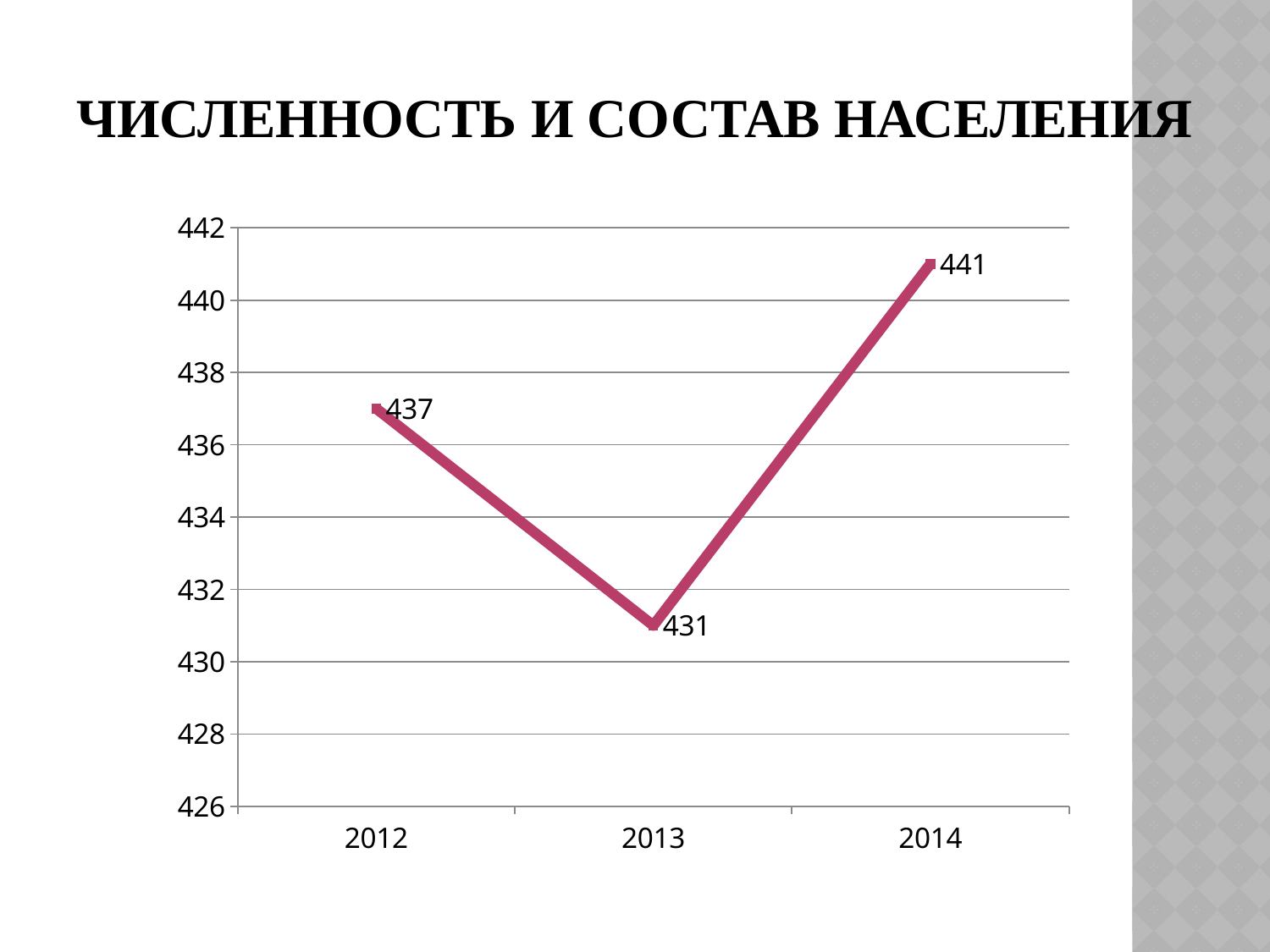
What is the difference between the values for 2014 and 2013? 10 Is the value for 2013 greater or less than 432? less What is the value for 2013? 431 Which is larger, the value for 2012 or the value for 2014? 2014 Which year has the lowest value? 2013 How many years are plotted on the chart? 3 What is the value for 2014? 441 Does the value rise or fall from 2013 to 2014? rise What is the difference between the values for 2012 and 2013? 6 What is the value for 2012? 437 What kind of chart is shown on the slide? line chart Which year has the highest value? 2014